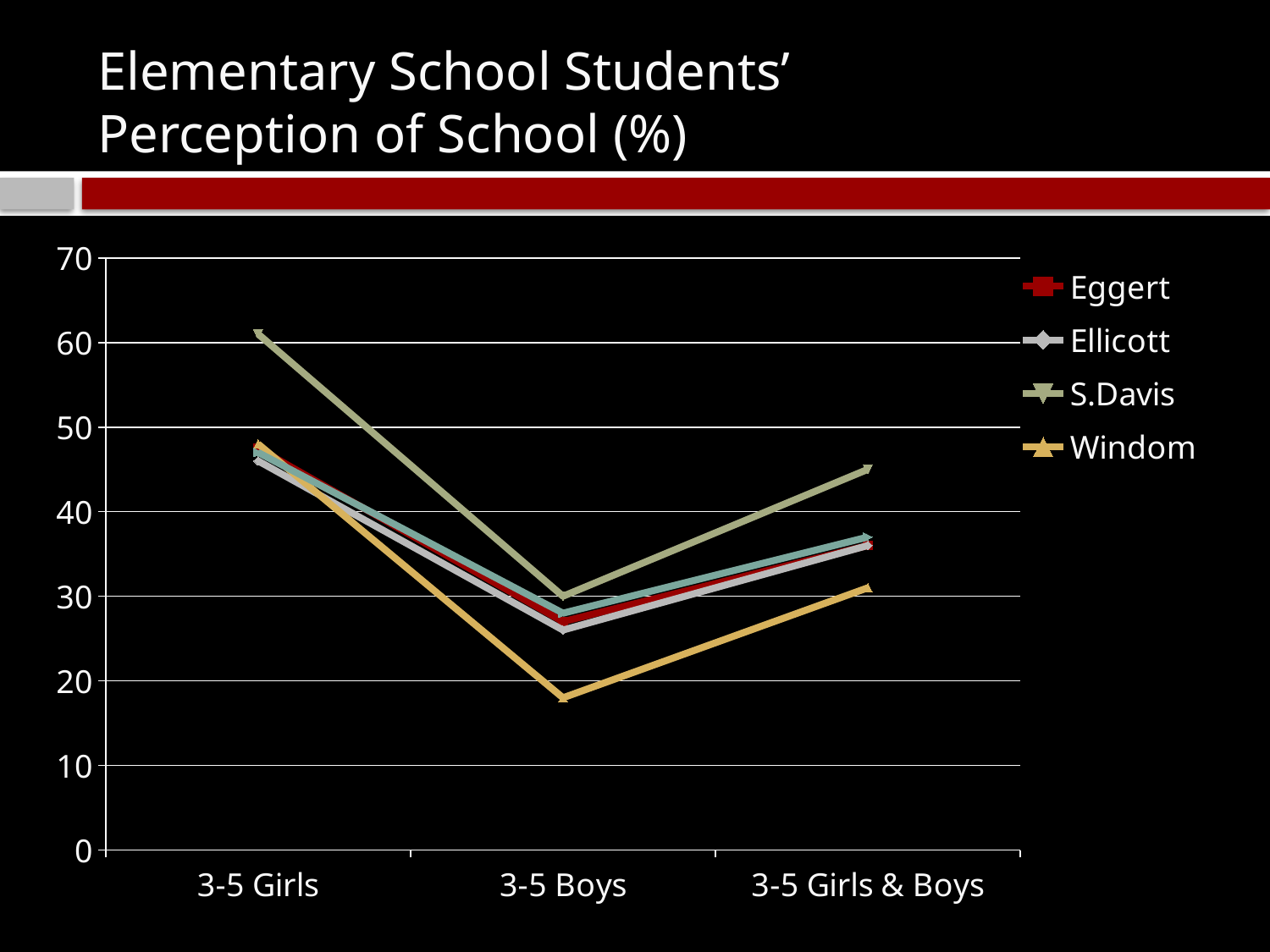
Which school has the lowest value for 3-5 Boys? Windom Which is larger at 3-5 Boys, the value for S.Davis or the value for Windom? S.Davis Is the value for S.Davis at 3-5 Girls & Boys greater or less than 40? greater Which school has the highest value for 3-5 Girls? S.Davis How many categories are shown on the x axis? 3 Does the S.Davis line rise or fall from 3-5 Girls to 3-5 Boys? fall What kind of chart is shown on the slide? line chart What is the title of the slide? Elementary School Students' Perception of School (%) How many series does the legend list? 4 Which school has the lowest value for 3-5 Girls & Boys? Windom Is the value for Windom at 3-5 Boys greater or less than 20? less Is the value for S.Davis at 3-5 Girls greater or less than 50? greater